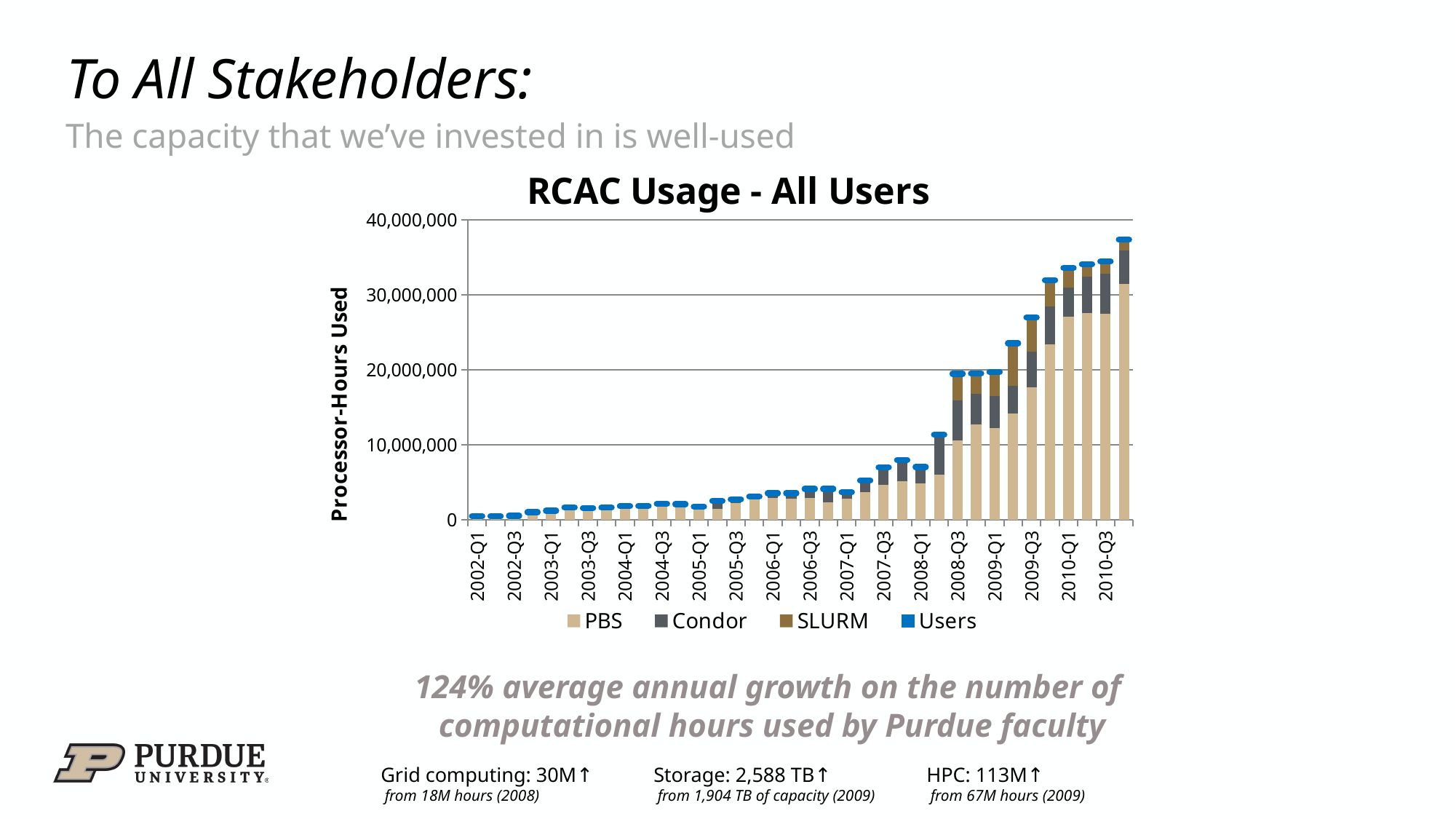
Which quarter has a larger total, 2008-Q3 or 2009-Q3? 2009-Q3 Is the total value for 2007-Q3 greater or less than 10,000,000? less What kind of chart is shown on the slide? Stacked bar chart Which quarter has the highest total processor-hours used? 2010-Q4 Do the total processor-hours used generally rise or fall from 2002-Q1 to 2010-Q4? Rise Which series forms the bottom (largest) segment of each stacked bar? PBS What is the label of the vertical axis? Processor-Hours Used Which quarter has a larger total, 2005-Q1 or 2008-Q1? 2008-Q1 How many series does the chart's legend list? 4 What is the title of the chart? RCAC Usage - All Users Is the total value for 2010-Q3 greater or less than 30,000,000? greater